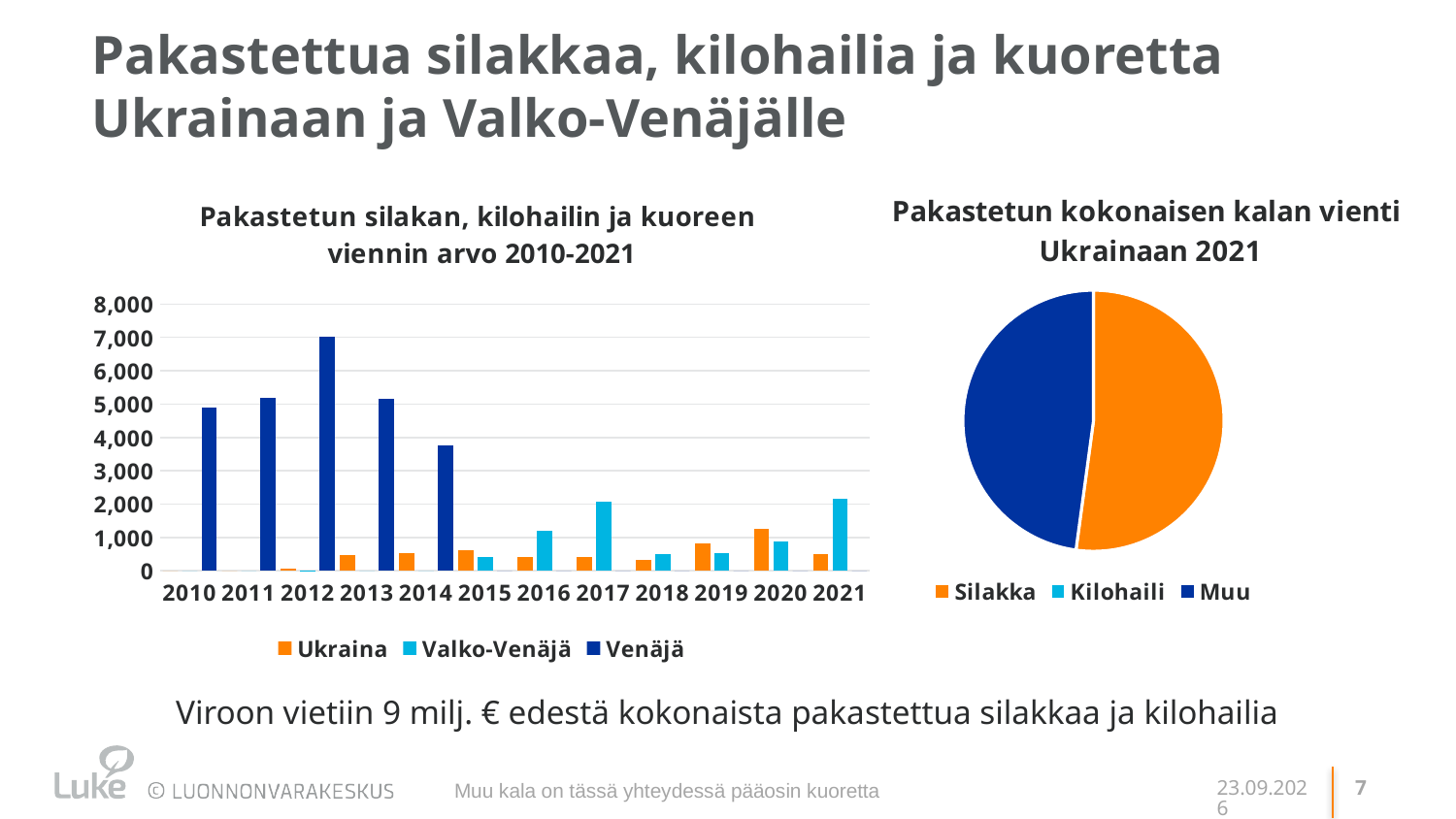
In the bar chart 'Pakastetun silakan, kilohailin ja kuoreen viennin arvo 2010-2021', how many years are shown on the x axis? 12 In the bar chart 'Pakastetun silakan, kilohailin ja kuoreen viennin arvo 2010-2021', do the Venäjä values rise or fall from 2012 to 2014? fall In the pie chart 'Pakastetun kokonaisen kalan vienti Ukrainaan 2021', what entries does the legend list? Silakka, Kilohaili, Muu What kind of chart is 'Pakastetun silakan, kilohailin ja kuoreen viennin arvo 2010-2021'? Bar chart In the bar chart 'Pakastetun silakan, kilohailin ja kuoreen viennin arvo 2010-2021', is the Venäjä value for 2014 greater or less than 4,000? less In the bar chart 'Pakastetun silakan, kilohailin ja kuoreen viennin arvo 2010-2021', how many series does the legend list? 3 In the bar chart 'Pakastetun silakan, kilohailin ja kuoreen viennin arvo 2010-2021', in which year is the Venäjä value highest? 2012 In the bar chart 'Pakastetun silakan, kilohailin ja kuoreen viennin arvo 2010-2021', in which year is the Ukraina value highest? 2020 In the bar chart 'Pakastetun silakan, kilohailin ja kuoreen viennin arvo 2010-2021', is the Venäjä value for 2012 greater or less than 6,000? greater What kind of chart is 'Pakastetun kokonaisen kalan vienti Ukrainaan 2021'? Pie chart In the bar chart 'Pakastetun silakan, kilohailin ja kuoreen viennin arvo 2010-2021', is the Ukraina value for 2020 greater or less than 1,000? greater In the bar chart 'Pakastetun silakan, kilohailin ja kuoreen viennin arvo 2010-2021', which is larger in 2017: Ukraina or Valko-Venäjä? Valko-Venäjä